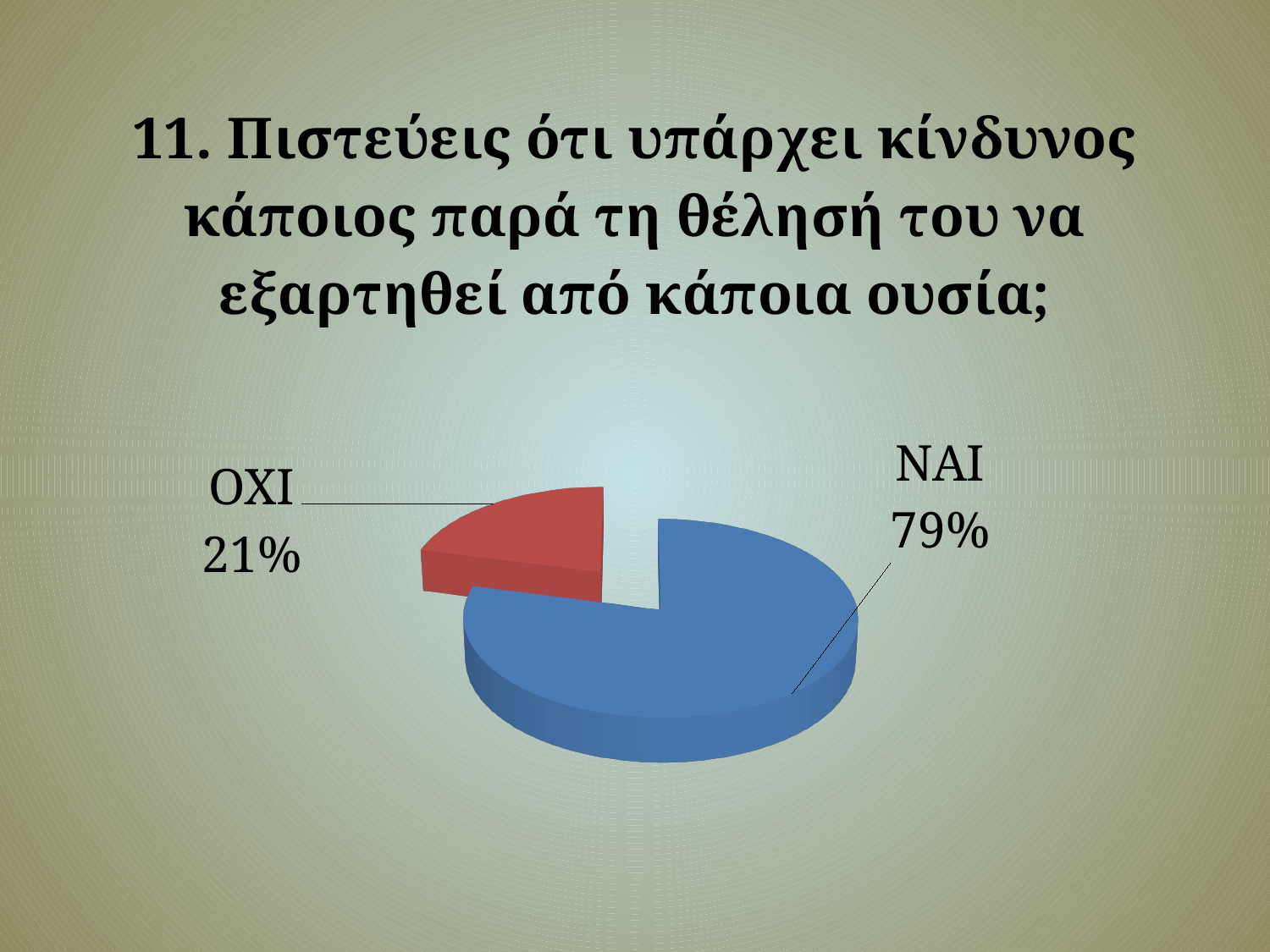
What share of the pie does the ΟΧΙ slice represent? 21% What colour is the ΝΑΙ slice? blue Which is larger, the share for ΝΑΙ or the share for ΟΧΙ? ΝΑΙ Which category has the largest share of the pie? ΝΑΙ How many slices does the pie chart have? 2 What is the difference between the ΝΑΙ and ΟΧΙ shares? 58% What colour is the ΟΧΙ slice? red What is the value for ΟΧΙ? 21% What kind of chart is shown on the slide? pie chart What is the value for ΝΑΙ? 79% Which category has the smallest share of the pie? ΟΧΙ